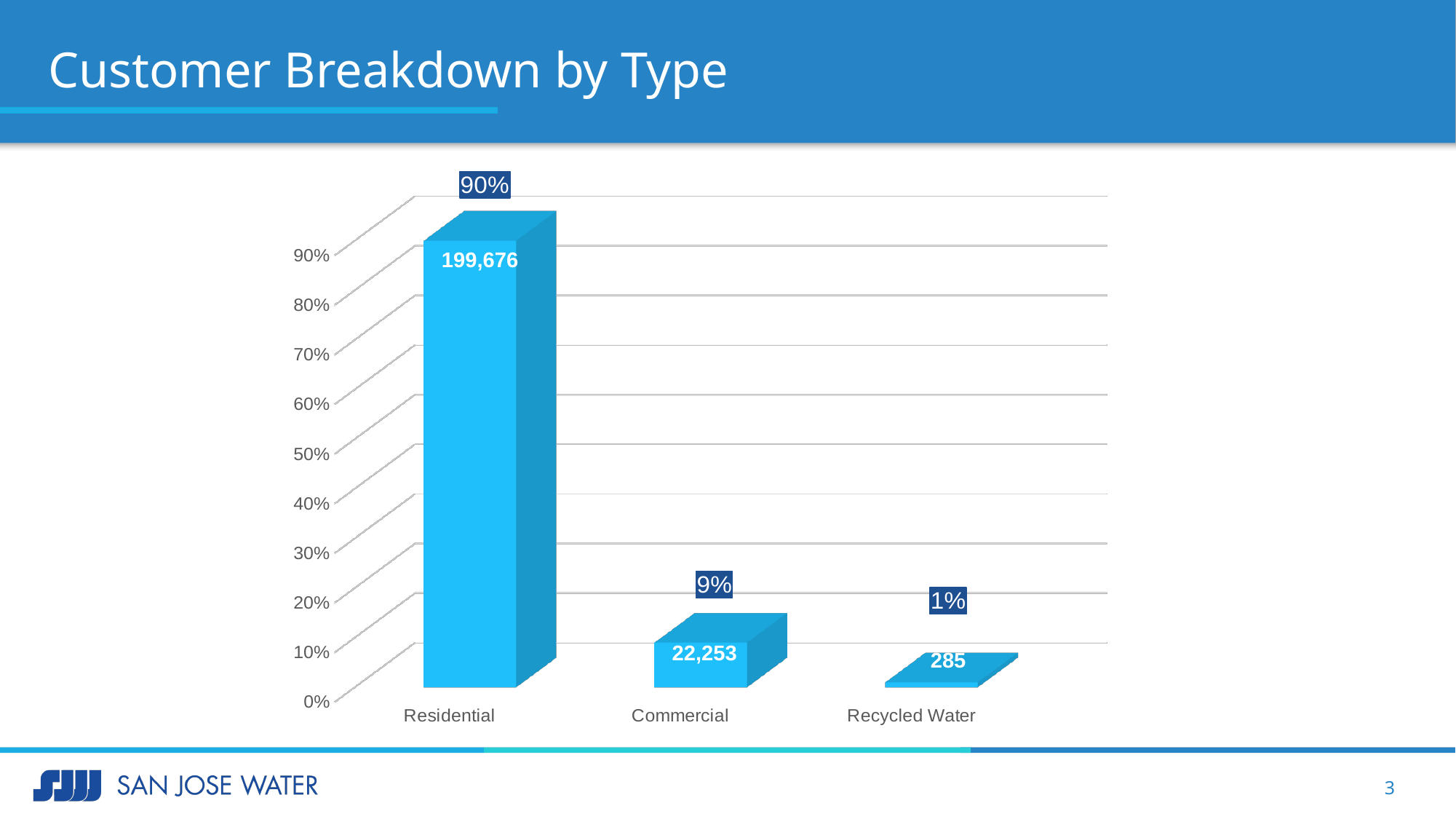
What is the difference in percentage points between the Residential and Commercial shares? 81% Which has a larger share, Commercial or Recycled Water? Commercial Is the value for Commercial greater or less than 20%? less Which customer type has the highest share? Residential Which customer type has the lowest share? Recycled Water How many more customers are Residential than Commercial? 177,423 What is the customer count labelled on the Commercial bar? 22,253 What percentage share is shown for Residential customers? 90% What kind of chart is shown on the slide? Bar chart What percentage share is shown for Commercial customers? 9% What is the customer count labelled on the Recycled Water bar? 285 How many customer types are shown on the chart? 3